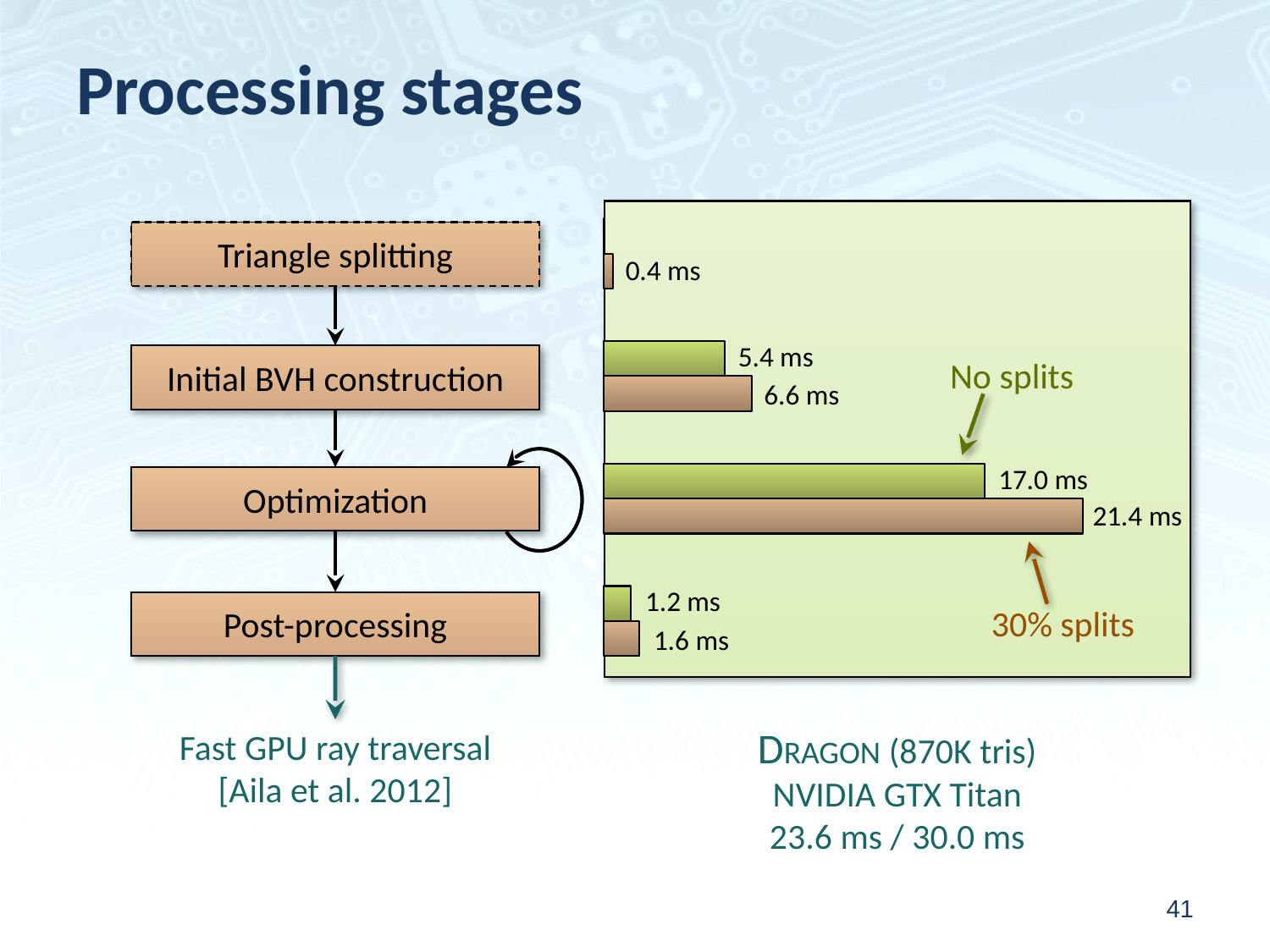
What is the difference between the Optimization times for 30% splits and no splits? 4.4 ms What is the time for Post-processing with no splits? 1.2 ms What kind of chart is shown on the slide? Bar chart How many series does the chart show? 2 What is the time for Optimization with 30% splits? 21.4 ms What is the time for Triangle splitting with 30% splits? 0.4 ms Which processing stage takes the shortest time with 30% splits? Triangle splitting Which is larger for Post-processing: the no splits time or the 30% splits time? 30% splits What is the difference between the Initial BVH construction times for 30% splits and no splits? 1.2 ms Which processing stage takes the longest time with 30% splits? Optimization Which colour represents the 30% splits series in the chart? Brown What is the time for Initial BVH construction with no splits? 5.4 ms